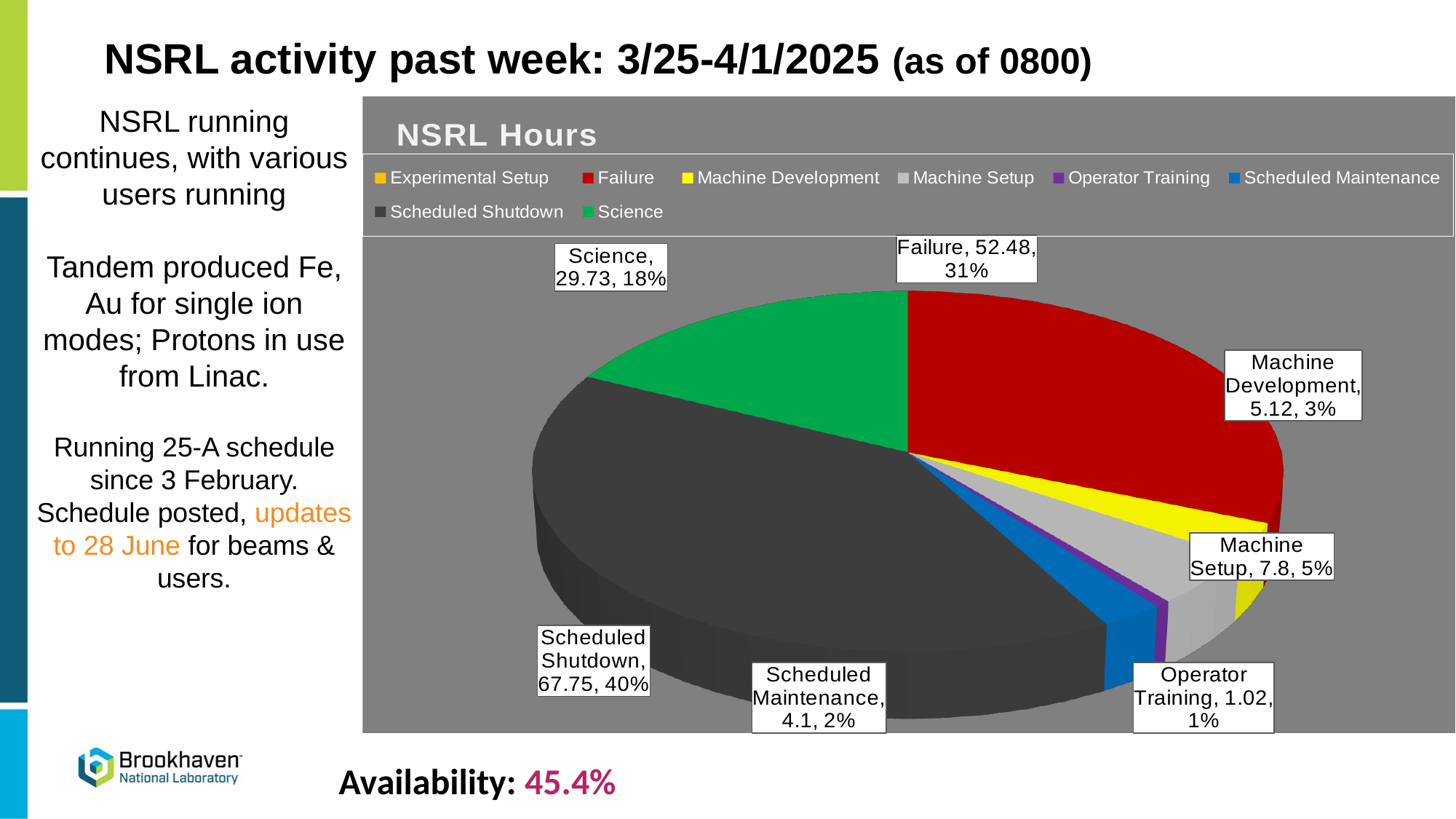
Which category has the largest slice of the pie? Scheduled Shutdown How many entries does the chart legend list? 8 How many hours are shown for Failure? 52.48 Which labelled category has the smallest slice of the pie? Operator Training What share of the pie does Science represent? 18% What is the title of the chart? NSRL Hours What kind of chart is shown on the slide? Pie chart What is the difference in hours between Failure and Science? 22.75 How many hours are shown for Scheduled Maintenance? 4.1 What share of the pie does Machine Setup represent? 5% Which has more hours, Machine Setup or Machine Development? Machine Setup How many hours are shown for Scheduled Shutdown? 67.75